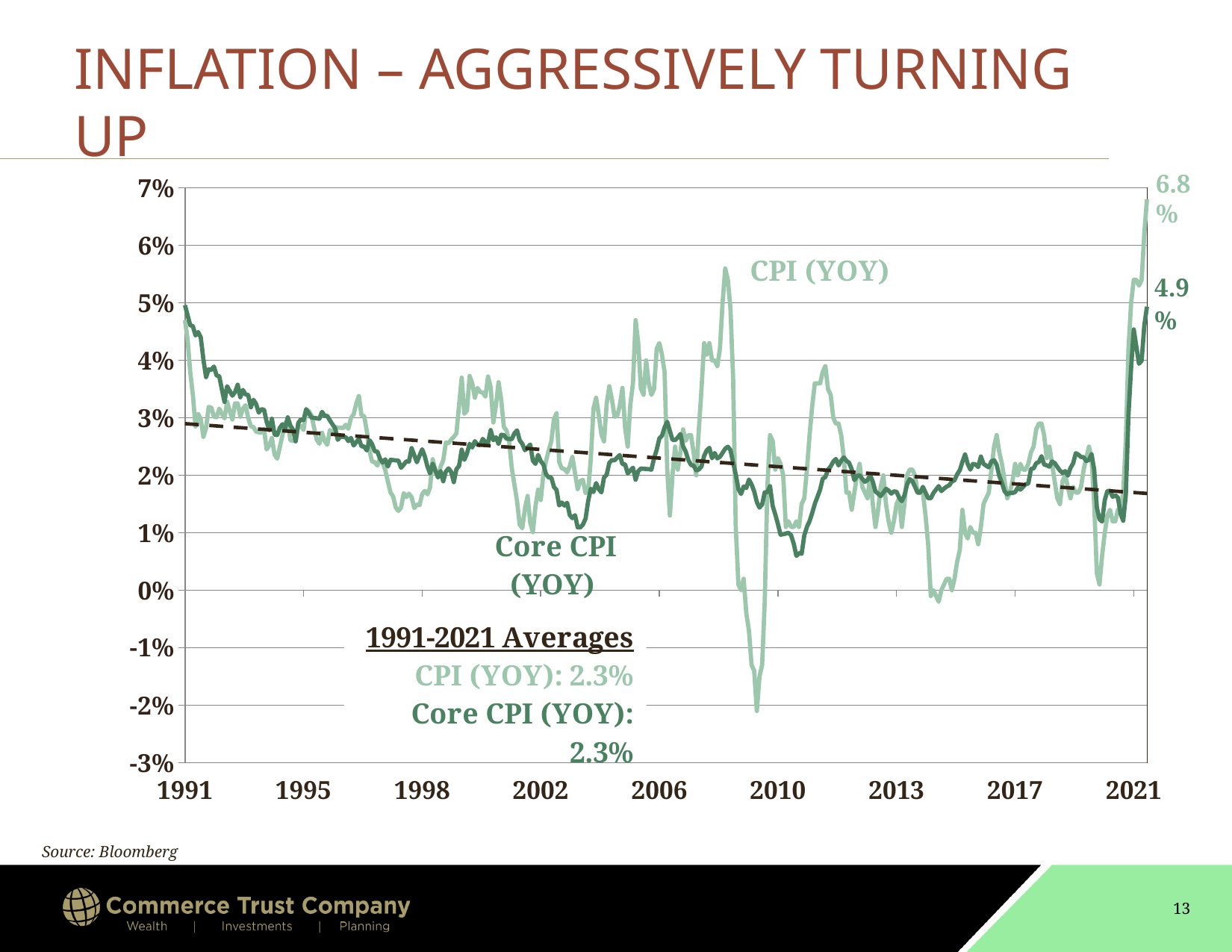
At the right end of the chart, which series is higher: CPI (YOY) or Core CPI (YOY)? CPI (YOY) What is the 1991-2021 average for Core CPI (YOY) shown on the chart? 2.3% What is the latest labeled value of CPI (YOY) at the right end of the chart? 6.8% What kind of chart is shown on the slide? line chart What is the difference between the latest labeled CPI (YOY) value and the latest labeled Core CPI (YOY) value? 1.9% What source is cited for the chart data? Bloomberg Does the dashed trend line rise or fall from 1991 to 2021? fall What is the latest labeled value of Core CPI (YOY) at the right end of the chart? 4.9% Is the value of Core CPI (YOY) at the start of 1991 greater or less than 4%? greater Is the lowest value of CPI (YOY) around 2009 greater or less than -1%? less Is the peak value of CPI (YOY) around 2008 greater or less than 5%? greater What is the 1991-2021 average for CPI (YOY) shown on the chart? 2.3%